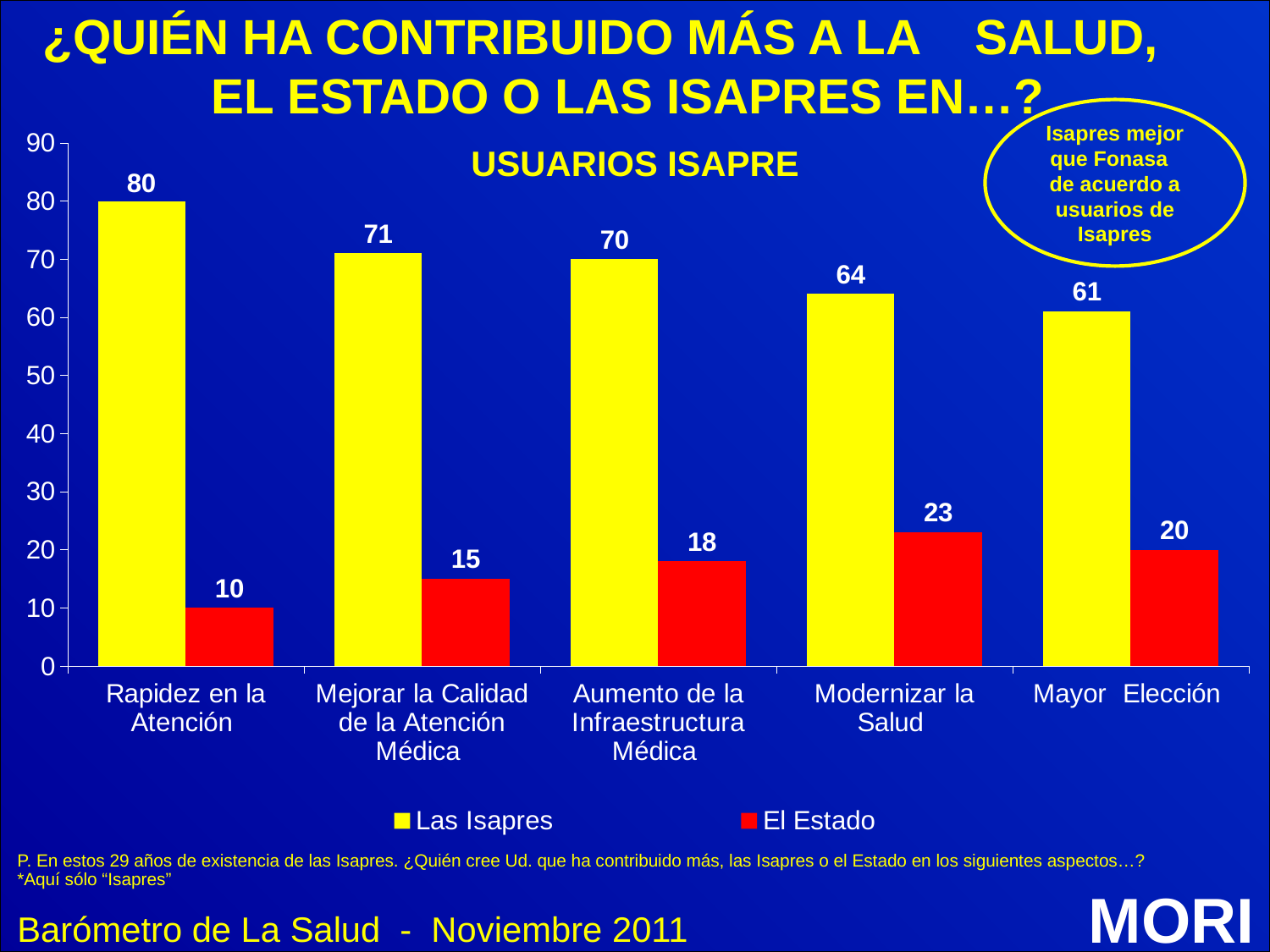
Which is larger in the category Mejorar la Calidad de la Atención Médica, Las Isapres or El Estado? Las Isapres What is the value for Las Isapres in the category Mayor Elección? 61 Do the values for Las Isapres rise or fall from left to right across the categories? Fall What kind of chart is shown on the slide? Bar chart Which category has the highest value for Las Isapres? Rapidez en la Atención Which category has the lowest value for El Estado? Rapidez en la Atención How many categories are shown on the x axis? 5 What is the difference between Las Isapres and El Estado in the category Aumento de la Infraestructura Médica? 52 What is the value for Las Isapres in the category Rapidez en la Atención? 80 How many series does the legend list? 2 What is the value for El Estado in the category Modernizar la Salud? 23 What colour are the bars for El Estado? Red